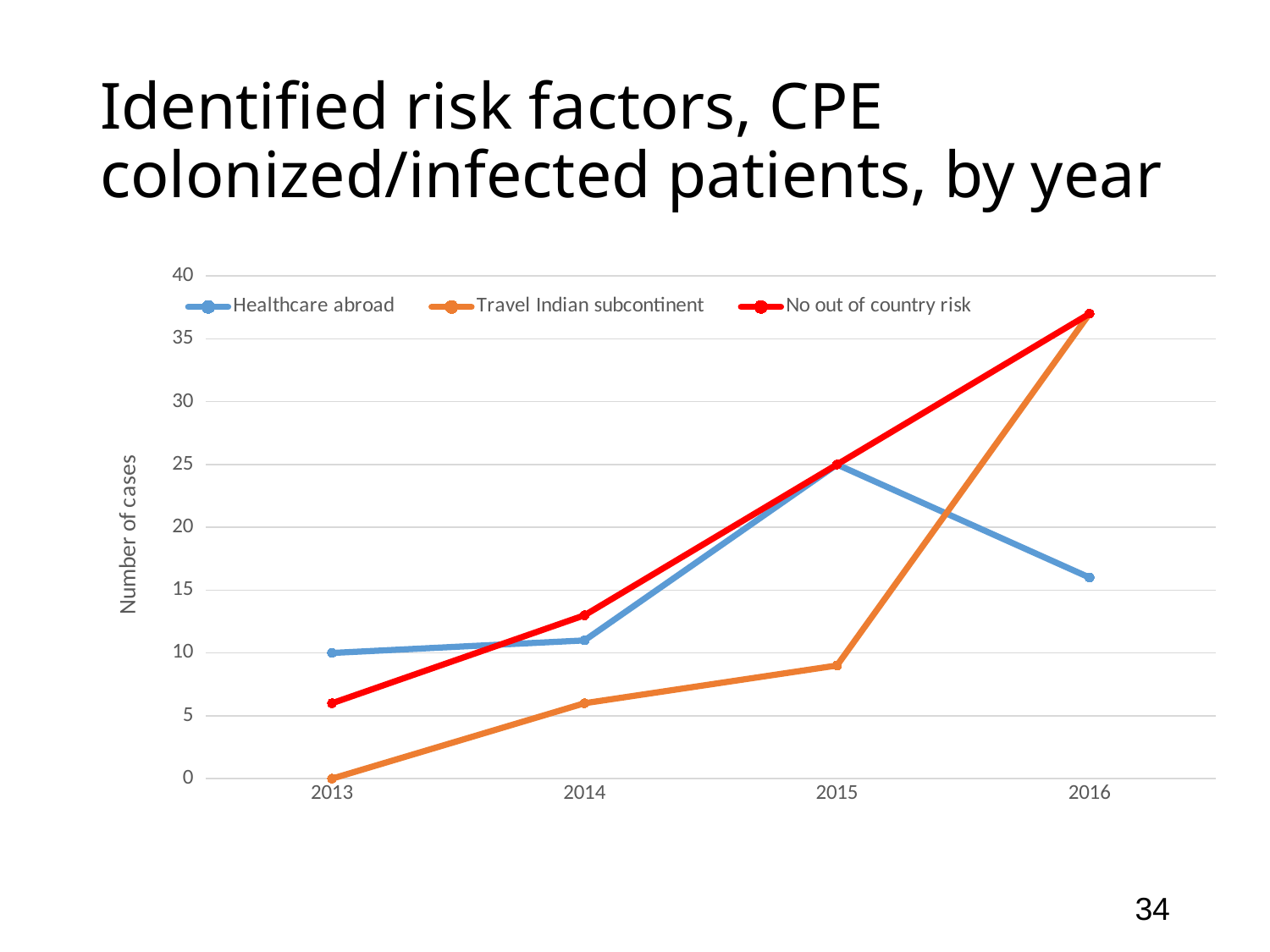
Is the value for Healthcare abroad in 2016 greater or less than 20? less Is the value for Travel Indian subcontinent in 2016 greater or less than 35? greater Which series has the highest value in 2013? Healthcare abroad Which series has the lowest value in 2016? Healthcare abroad What is the value for No out of country risk in 2015? 25 Does the Travel Indian subcontinent series rise or fall from 2013 to 2016? Rise How many years are plotted along the x axis? 4 What is the value for Healthcare abroad in 2015? 25 What kind of chart is shown on the slide? Line chart What is the value for Travel Indian subcontinent in 2013? 0 What is the value for Healthcare abroad in 2013? 10 How many series does the legend list? 3